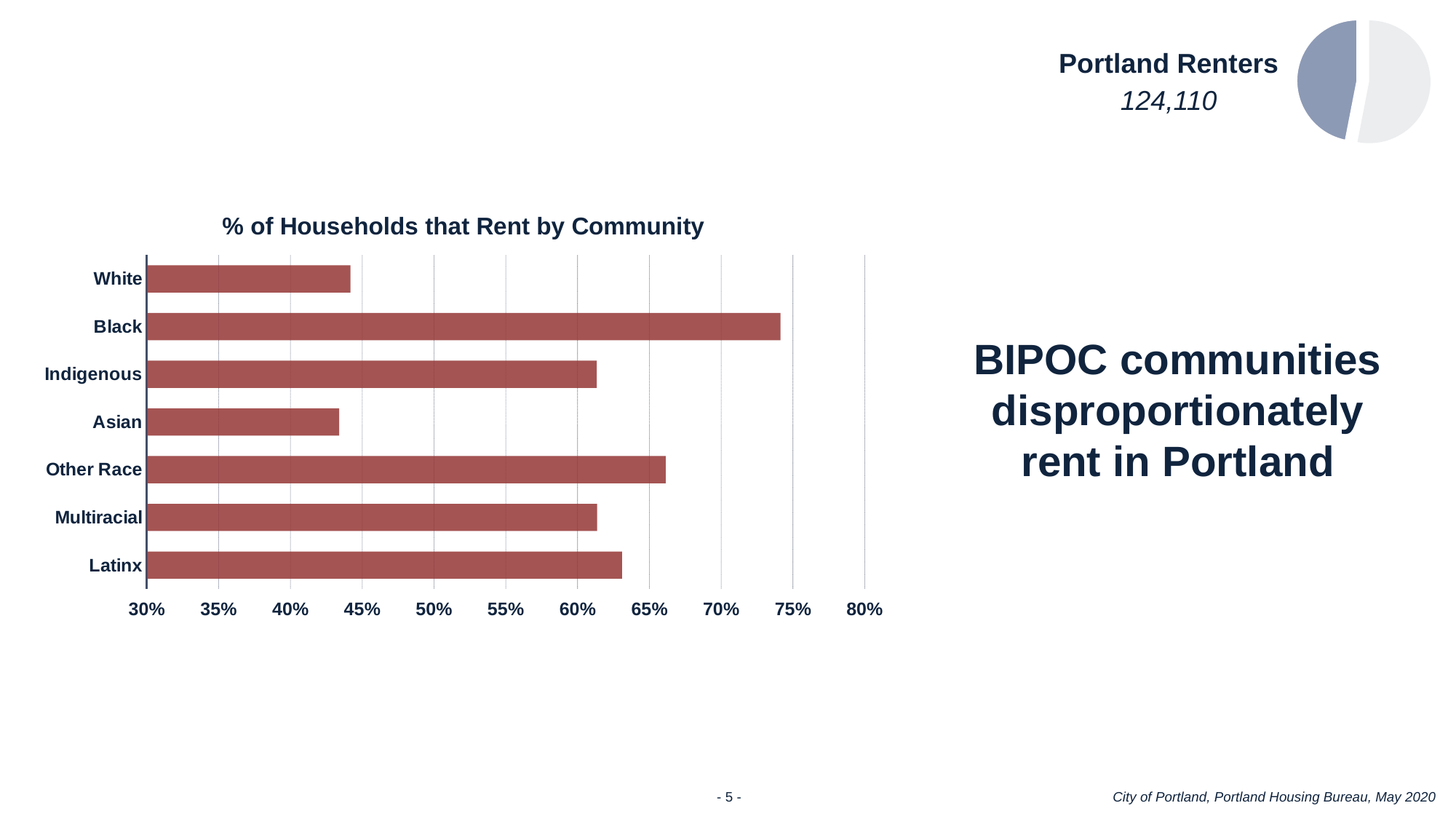
What is the title of the bar chart on the slide? % of Households that Rent by Community Is the value for Black greater or less than 70%? greater Is the value for White greater or less than 45%? less Is the value for Indigenous greater or less than 60%? greater How many communities are shown in the % of Households that Rent by Community chart? 7 Which has a higher share of households that rent, Other Race or Latinx? Other Race What kind of chart is used to show % of Households that Rent by Community? bar chart Which has a higher share of households that rent, Black or White? Black Which community has the highest share of households that rent? Black